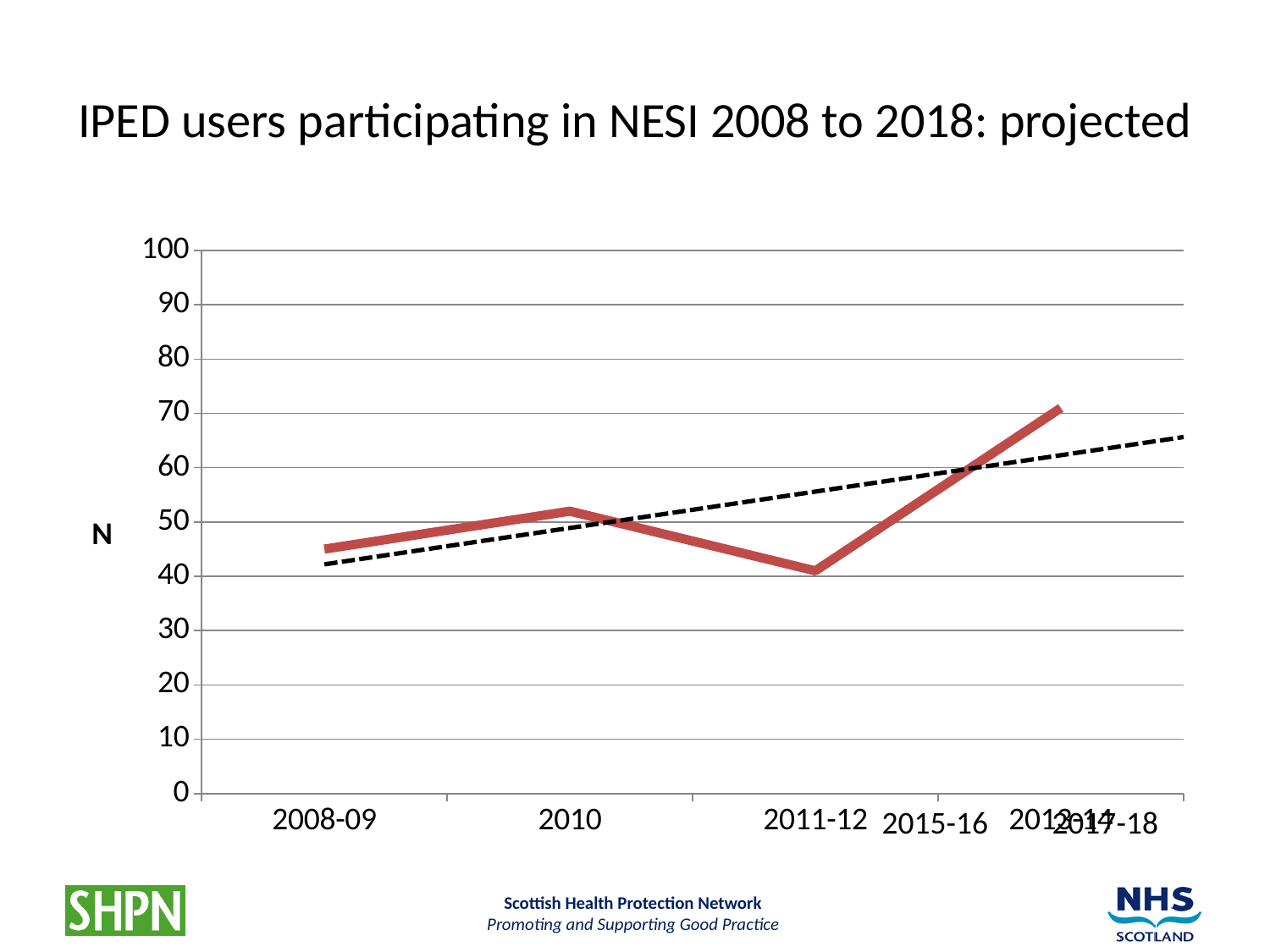
What kind of chart is shown on the slide? line chart Is the value of the solid red line for 2008-09 greater or less than 40? greater Is the value of the solid red line for 2008-09 greater or less than 50? less What is the title of the chart? IPED users participating in NESI 2008 to 2018: projected Does the solid red line rise or fall from 2010 to 2011-12? fall Which has the larger value on the solid red line, 2010 or 2011-12? 2010 What is the label on the y axis of the chart? N Is the value of the solid red line for 2011-12 greater or less than 50? less